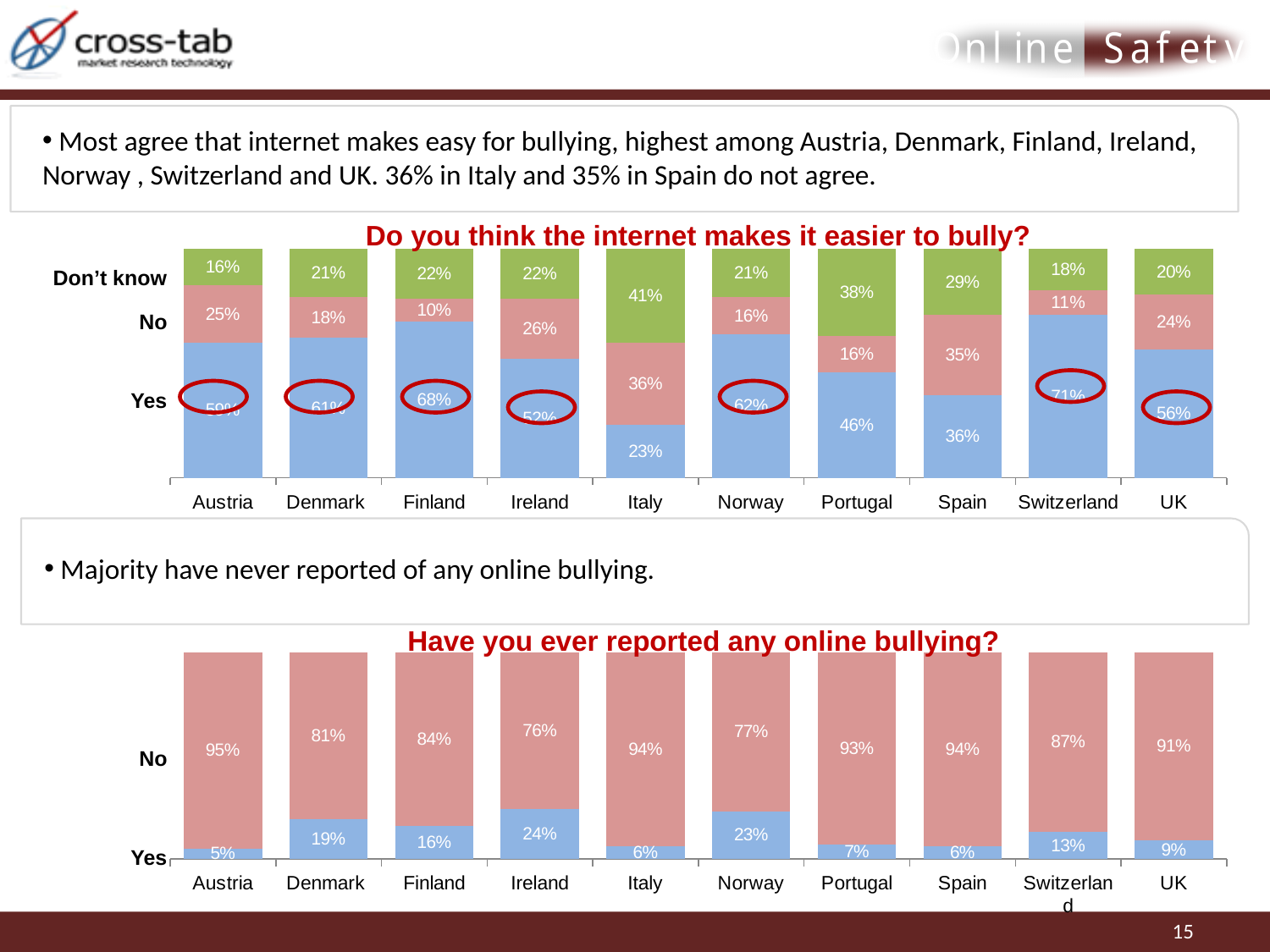
In the chart 'Do you think the internet makes it easier to bully?', which country has the lowest 'Yes' share? Italy In the chart 'Have you ever reported any online bullying?', which country has the highest 'No' share? Austria In the chart 'Do you think the internet makes it easier to bully?', how many countries are shown on the x axis? 10 In the chart 'Do you think the internet makes it easier to bully?', which country has the highest 'Don't know' share? Italy In the chart 'Have you ever reported any online bullying?', what is the difference between the 'No' values for Austria and Ireland? 19% What type of chart is 'Have you ever reported any online bullying?'? Stacked bar chart In the chart 'Do you think the internet makes it easier to bully?', what percentage of respondents in Finland answered Yes? 68% In the chart 'Have you ever reported any online bullying?', what percentage of respondents in Ireland answered Yes? 24% In the chart 'Have you ever reported any online bullying?', which is larger, the 'Yes' value for Denmark or the 'Yes' value for Switzerland? Denmark In the chart 'Do you think the internet makes it easier to bully?', what is the difference between the 'No' values for Italy and Finland? 26% In the chart 'Do you think the internet makes it easier to bully?', what is the 'Don't know' value for Italy? 41% In the chart 'Do you think the internet makes it easier to bully?', what is the 'No' value for Spain? 35%